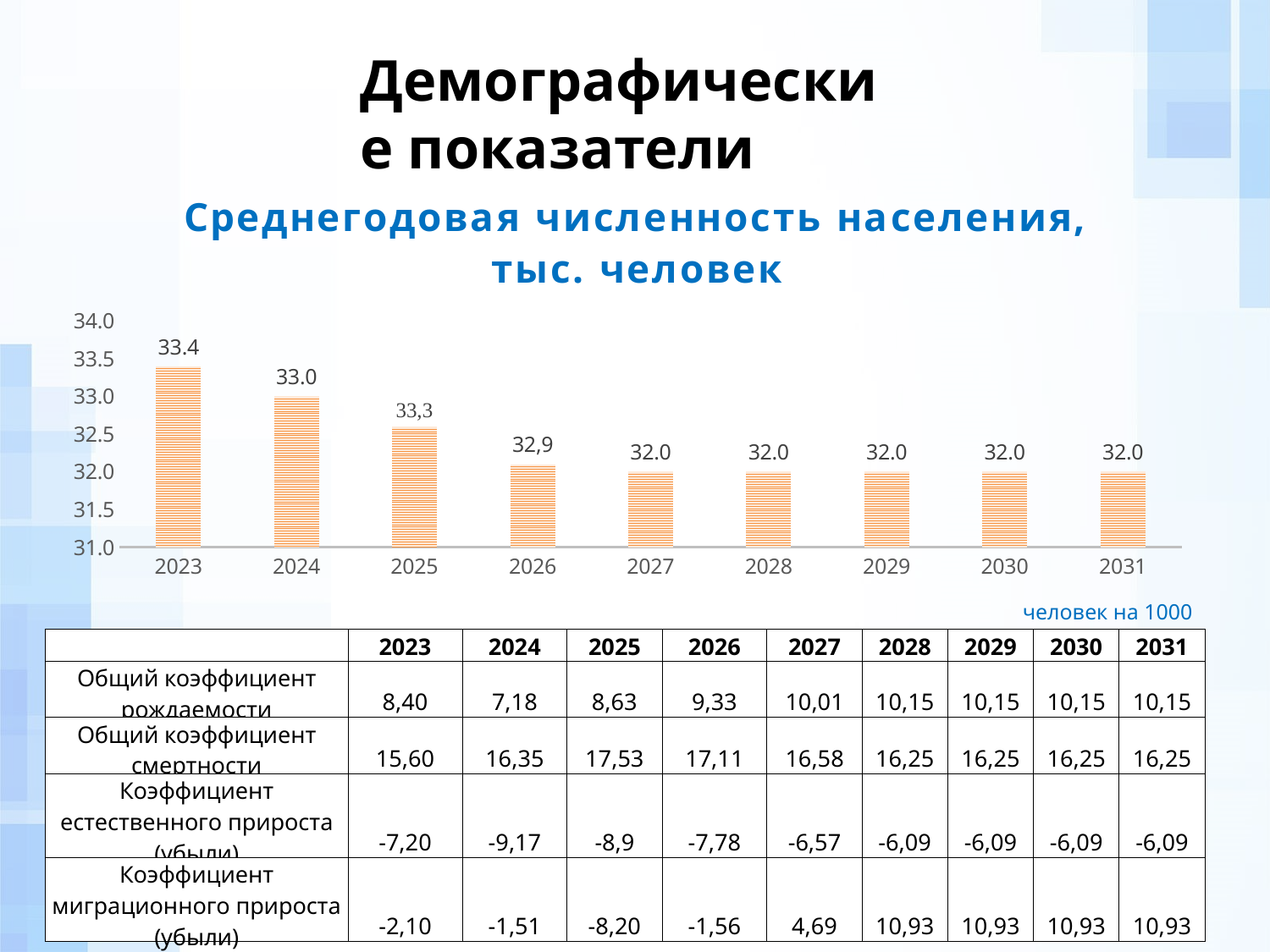
What is the average annual population value shown for 2023? 33.4 What kind of chart is shown on the slide? bar chart Do the values generally rise or fall from 2023 to 2031? fall How many years are plotted on the chart? 9 Is the value for 2027 greater or less than 32.5? less What is the difference between the values for 2023 and 2024? 0.4 What is the title of the chart? Среднегодовая численность населения, тыс. человек What is the average annual population value shown for 2031? 32.0 Which year has the highest average annual population on the chart? 2023 Which year has the larger value, 2023 or 2028? 2023 What is the average annual population value shown for 2024? 33.0 What is the difference between the values for 2023 and 2027? 1.4